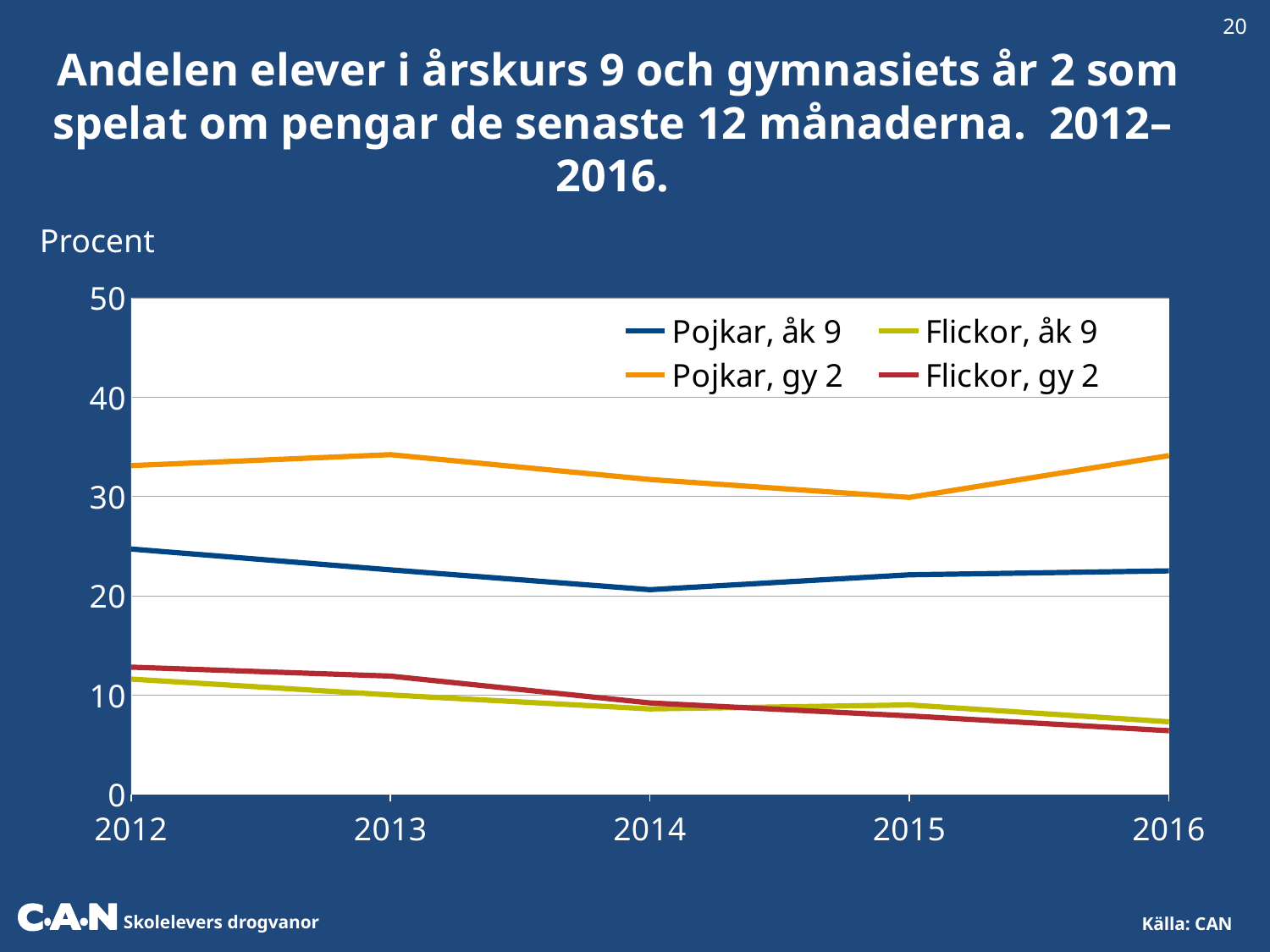
What unit is shown on the y axis label? Procent Is the value for Flickor, gy 2 in 2016 greater or less than 10? less Is the value for Pojkar, gy 2 in 2013 greater or less than 30? greater Is the value for Pojkar, åk 9 in 2014 greater or less than 30? less Which is larger in 2012: Flickor, gy 2 or Flickor, åk 9? Flickor, gy 2 How many years are shown on the x axis? 5 Which series has the lowest value in 2016? Flickor, gy 2 Which series has the highest values across all years? Pojkar, gy 2 How many series does the legend list? 4 What colour is the line for Pojkar, gy 2? orange What kind of chart is shown on the slide? line chart Does the Flickor, gy 2 line rise or fall from 2012 to 2016? fall